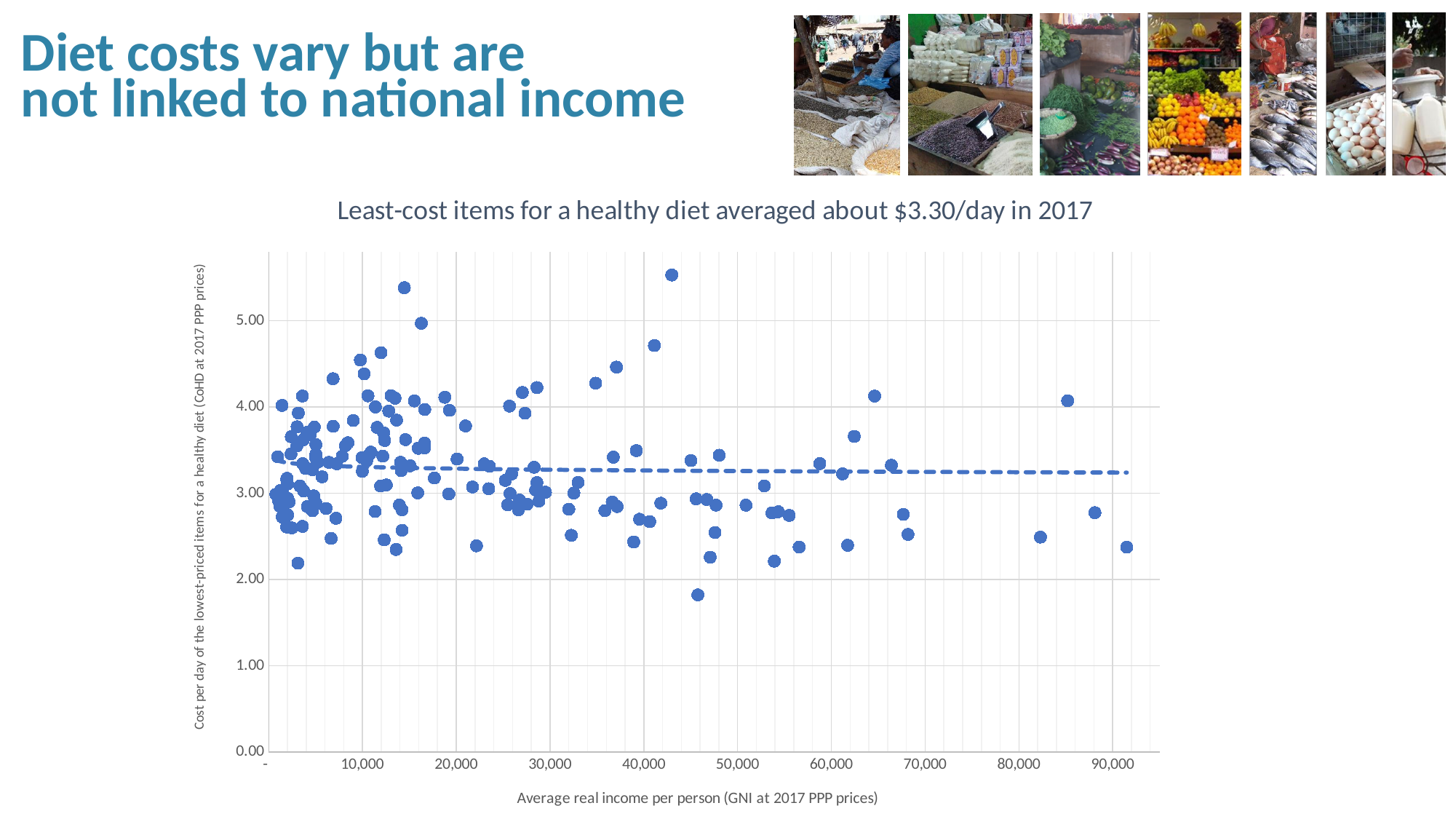
What is the label of the x axis of the chart? Average real income per person (GNI at 2017 PPP prices) Are there more points in the chart below 10,000 on the x axis or above 60,000 on the x axis? Below 10,000 Is the dashed trend line in the chart above or below 3.00 on the y axis? above What is the highest value labelled on the x axis of the chart? 90,000 What is the highest value labelled on the y axis of the chart? 5.00 Is the dashed trend line in the chart above or below 4.00 on the y axis? below Is the lowest point in the chart greater or less than 2.00 on the y axis? less What kind of chart is shown on the slide? Scatter plot What is the title of the chart? Least-cost items for a healthy diet averaged about $3.30/day in 2017 Does the dashed trend line in the chart rise, fall, or stay roughly flat as income increases along the x axis? Roughly flat